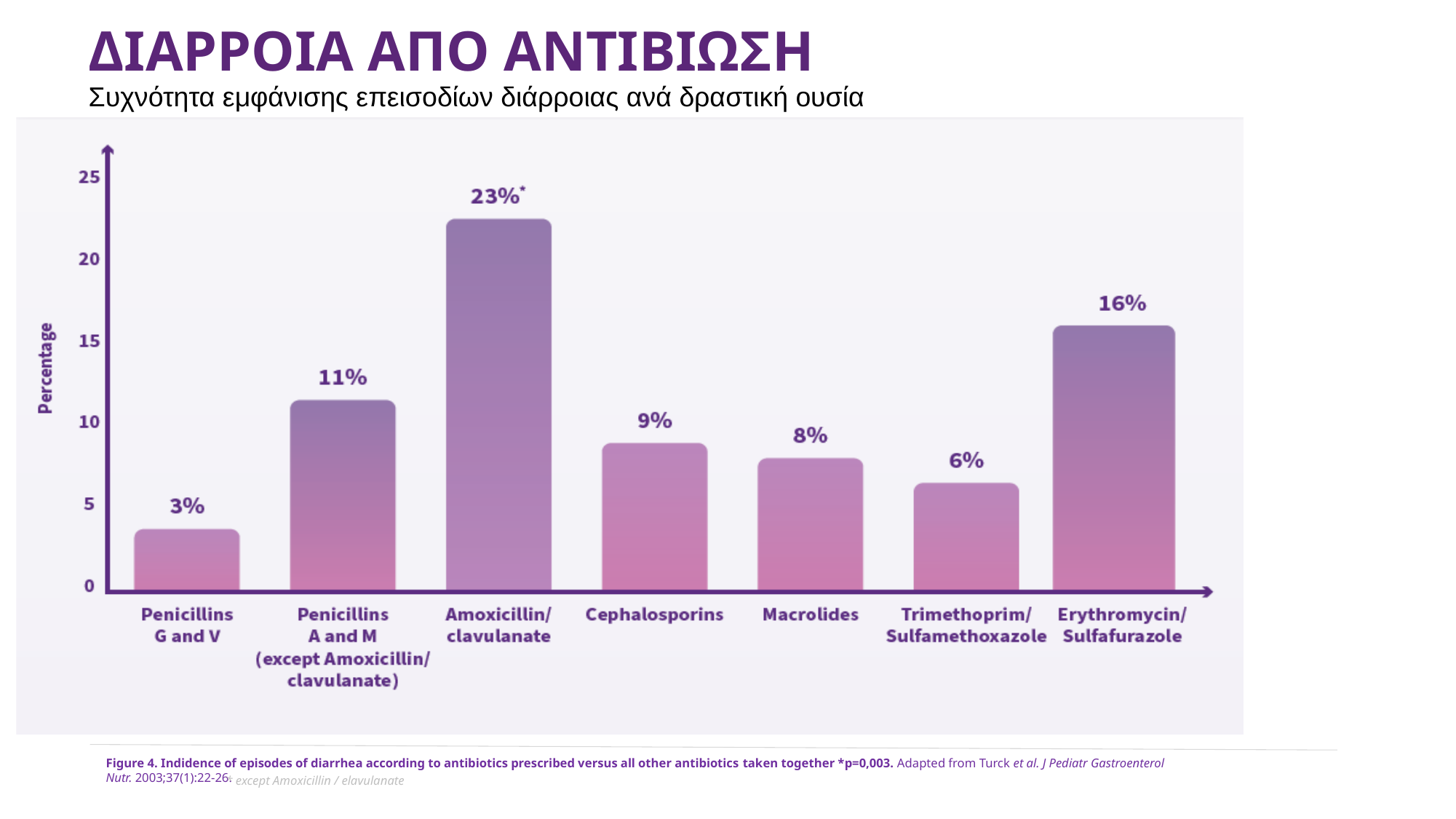
Which antibiotic category has the highest percentage? Amoxicillin/clavulanate What is the percentage for Macrolides? 8% What is the percentage for Amoxicillin/clavulanate? 23% What is the label of the vertical axis? Percentage Which has a higher percentage, Penicillins A and M (except Amoxicillin/clavulanate) or Cephalosporins? Penicillins A and M (except Amoxicillin/clavulanate) What is the difference in percentage between Cephalosporins and Trimethoprim/Sulfamethoxazole? 3% Which antibiotic category has the lowest percentage? Penicillins G and V What is the percentage for Penicillins G and V? 3% What is the percentage for Erythromycin/Sulfafurazole? 16% What is the difference in percentage between Amoxicillin/clavulanate and Erythromycin/Sulfafurazole? 7% What kind of chart is shown on the slide? Bar chart How many antibiotic categories are shown on the chart? 7